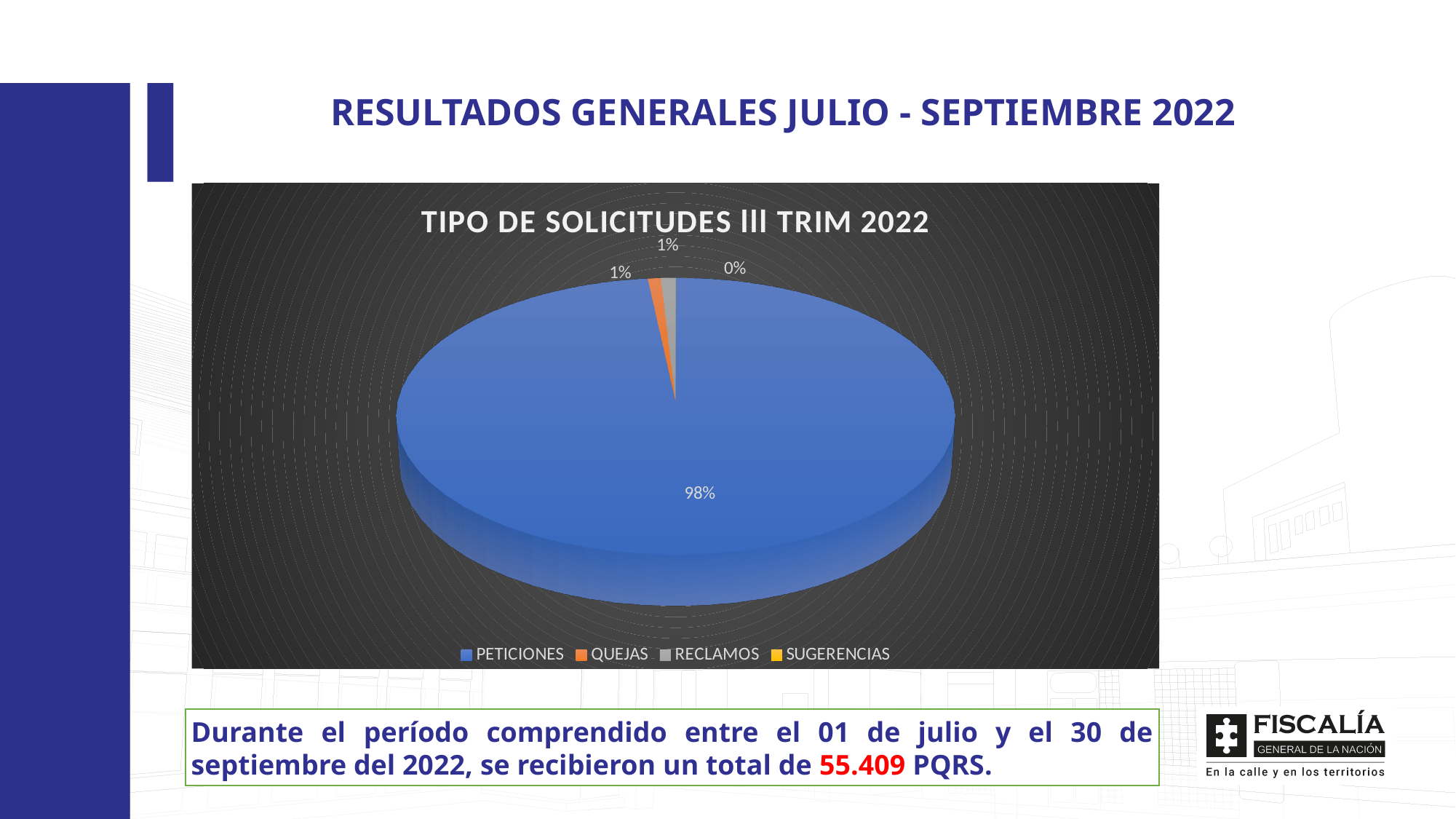
What is the difference in percentage points between the PETICIONES share and the QUEJAS share? 97 percentage points Which category has the largest share of the pie? PETICIONES Which category has the smallest share of the pie? SUGERENCIAS Which colour represents QUEJAS in the chart? Orange What is the title of the chart? TIPO DE SOLICITUDES III TRIM 2022 What kind of chart is shown on the slide? Pie chart What share of the pie does RECLAMOS represent? 1% Which is larger, the share for PETICIONES or the share for QUEJAS? PETICIONES How many categories does the pie chart show? 4 What share of the pie does SUGERENCIAS represent? 0% What share of the pie does PETICIONES represent? 98%